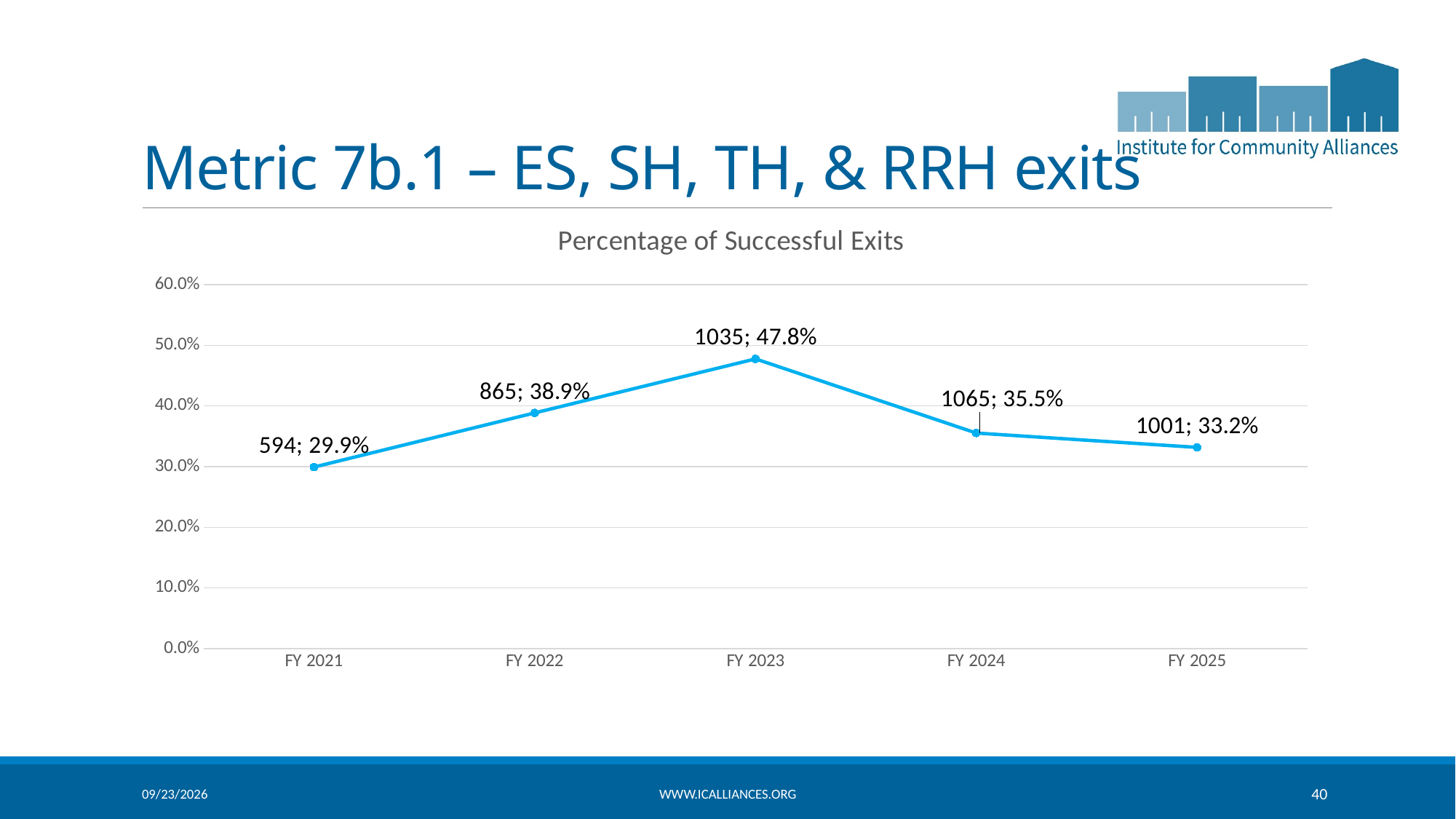
Does the percentage of successful exits rise or fall from FY 2023 to FY 2025? fall How many fiscal years are plotted on the chart? 5 Which fiscal year has the highest percentage of successful exits? FY 2023 What is the title of the chart? Percentage of Successful Exits What is the percentage of successful exits for FY 2023? 47.8% What kind of chart is shown on the slide? line chart What is the difference in percentage points between FY 2023 and FY 2024? 12.3 Which has a higher percentage of successful exits, FY 2022 or FY 2025? FY 2022 Is the value for FY 2025 greater or less than 40.0%? less What count is shown in the data label for FY 2024? 1065 What is the percentage of successful exits for FY 2021? 29.9% Which fiscal year has the lowest percentage of successful exits? FY 2021